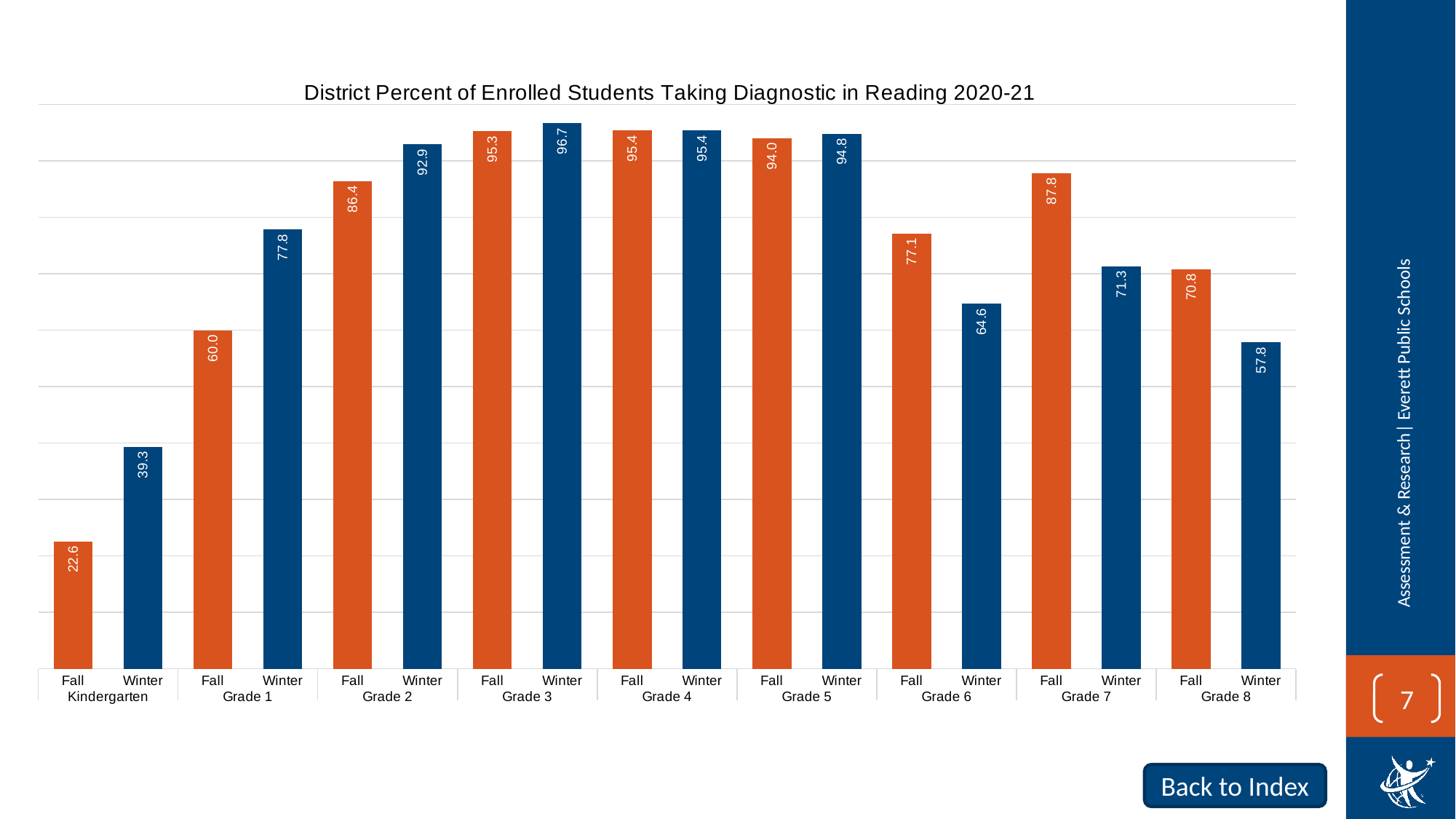
What kind of chart is shown on the slide? Bar chart What is the difference between the Winter and Fall values for Grade 1? 17.8 What is the title of the chart? District Percent of Enrolled Students Taking Diagnostic in Reading 2020-21 Which bar has the lowest value on the chart? Kindergarten Fall Which is larger for Grade 7, the Fall value or the Winter value? Fall What is the Winter value for Grade 3? 96.7 Which bar has the highest value on the chart? Grade 3 Winter What is the Fall value for Grade 7? 87.8 How many grade levels are shown on the chart? 9 What is the Winter value for Grade 8? 57.8 What is the difference between the Fall and Winter values for Grade 6? 12.5 What is the Fall value for Kindergarten? 22.6